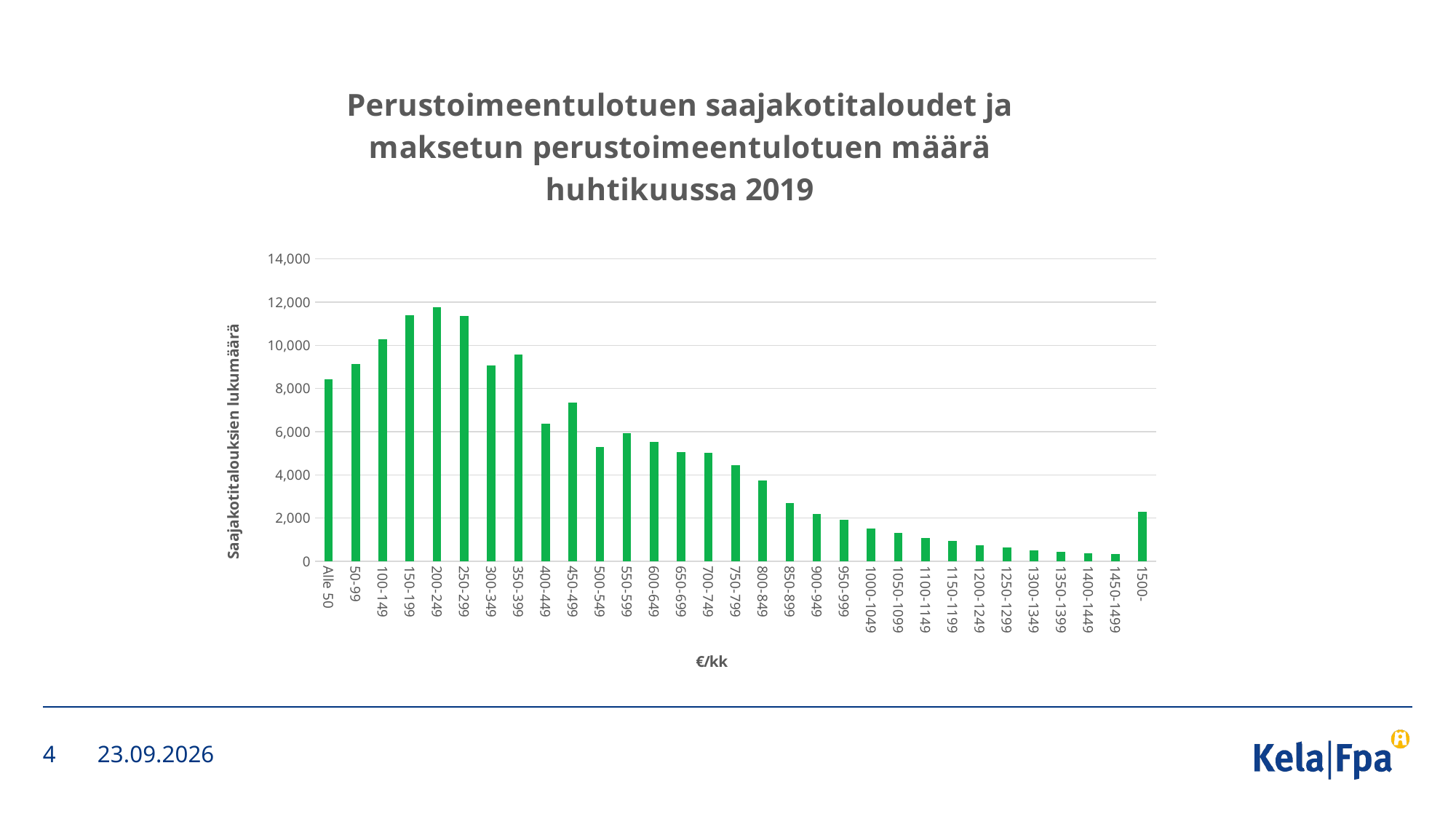
How many income categories are shown on the x axis? 31 Which has the larger value, '400-449' or '450-499'? 450-499 Is the value for '800-849' greater or less than 4,000? less What kind of chart is shown on the slide? bar chart Is the value for 'Alle 50' greater or less than 8,000? greater Which income category has the highest number of recipient households? 200-249 Is the value for '1000-1049' greater or less than 2,000? less What is the title of the x axis? €/kk Which has the larger value, '1450-1499' or '1500-'? 1500- Do the values rise or fall along the x axis from '200-249' to '1450-1499'? fall